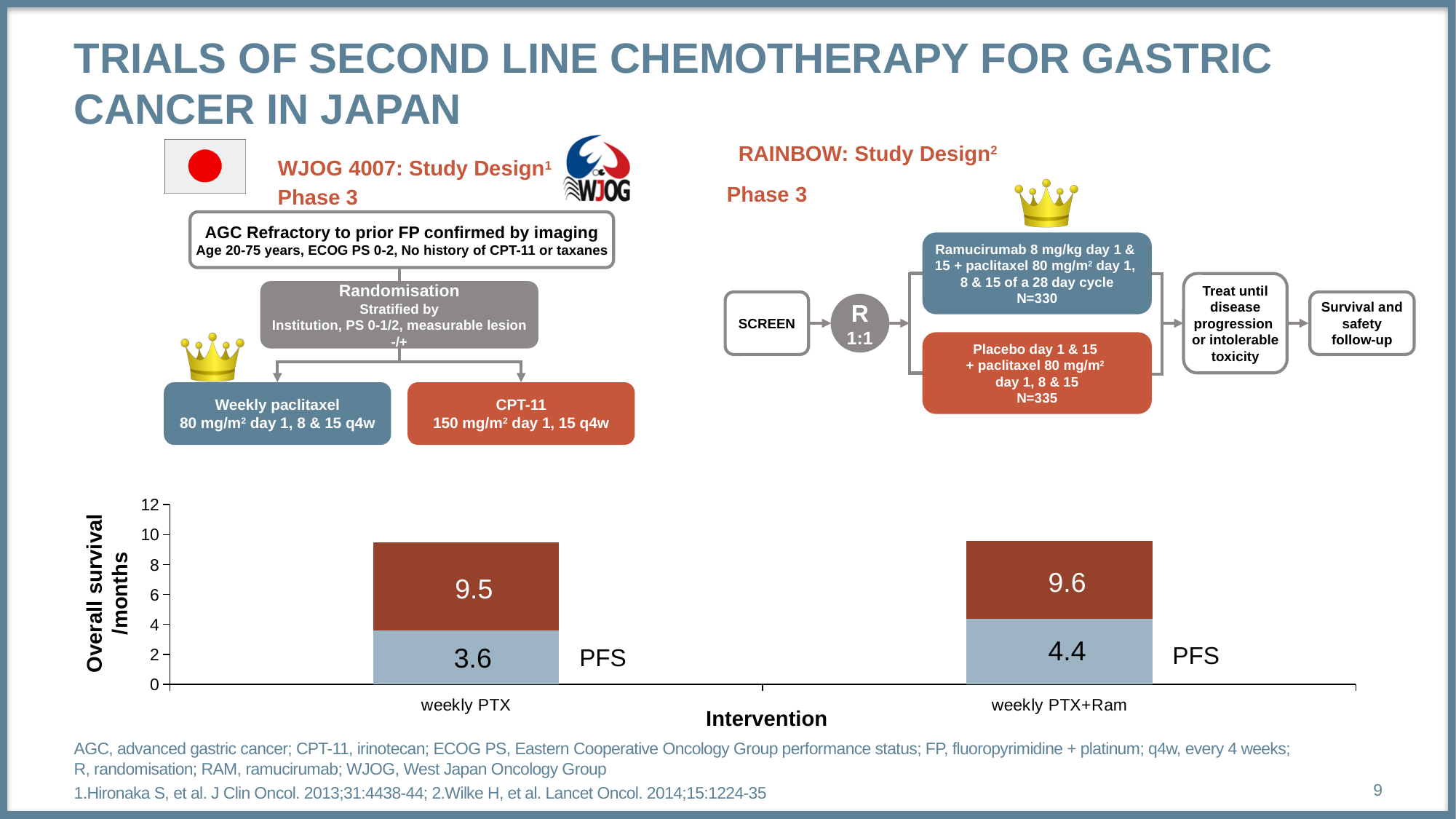
Which intervention has the higher PFS value in the bar chart? weekly PTX+Ram How many interventions (categories) are shown on the x axis of the bar chart? 2 What is the title of the y axis of the bar chart? Overall survival /months What is the PFS value shown for weekly PTX+Ram in the bar chart? 4.4 Which intervention has the lower PFS value in the bar chart? weekly PTX What value is printed on the upper (dark red) segment of the weekly PTX+Ram bar? 9.6 Is the top of the weekly PTX bar greater or less than 8 on the y axis? greater What is the PFS value shown for weekly PTX in the bar chart? 3.6 Is the PFS value for weekly PTX larger or smaller than the PFS value for weekly PTX+Ram? smaller What value is printed on the upper (dark red) segment of the weekly PTX bar? 9.5 What is the difference between the upper-segment values 9.6 (weekly PTX+Ram) and 9.5 (weekly PTX)? 0.1 What is the difference between the PFS values for weekly PTX+Ram and weekly PTX? 0.8